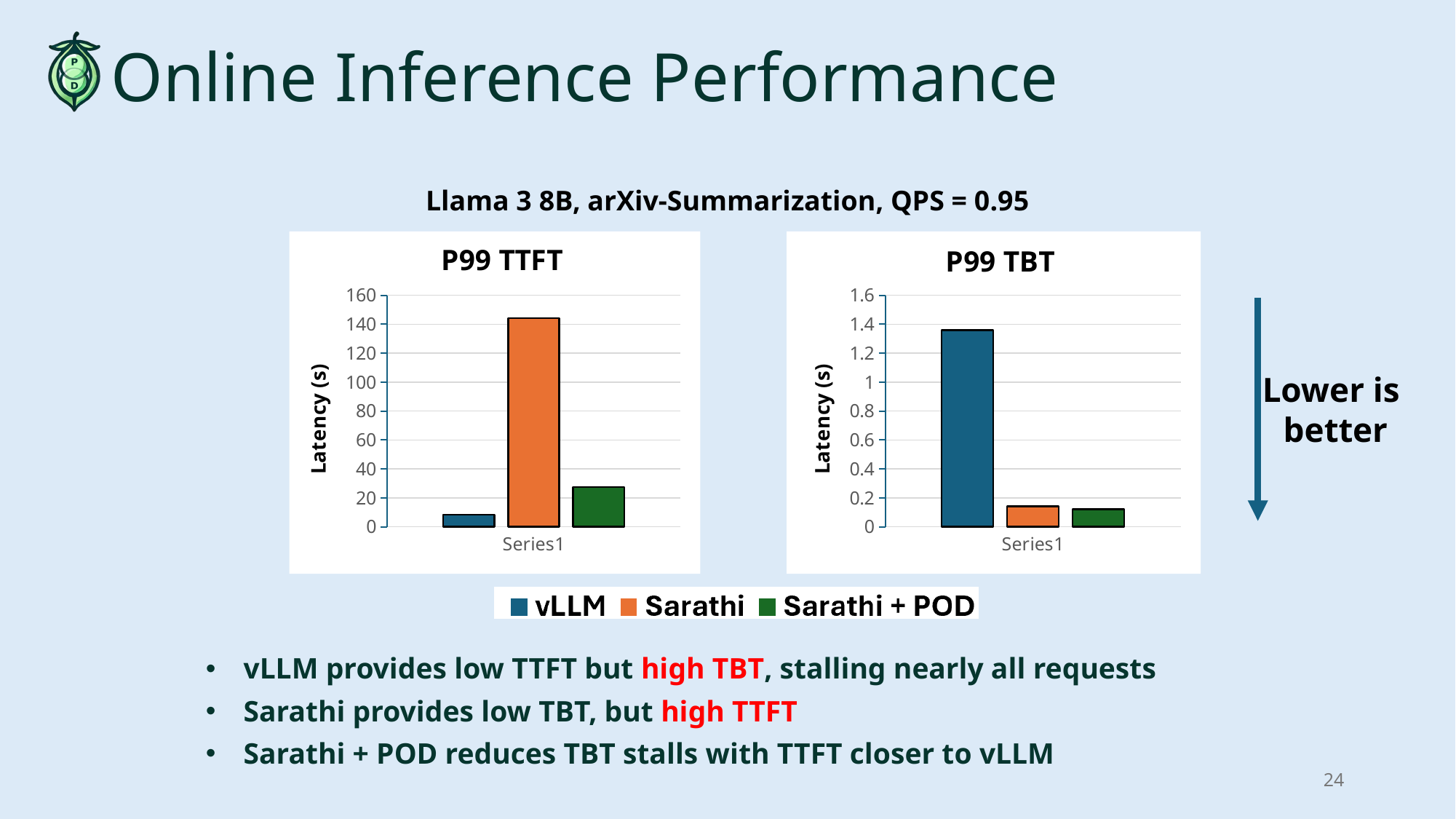
In the P99 TTFT chart, is the value for Sarathi greater or less than 140? greater What kind of chart is the P99 TBT chart? Bar chart In the P99 TBT chart, is the value for Sarathi greater or less than 0.4? less In the P99 TTFT chart, is the value for Sarathi + POD greater or less than 40? less In the P99 TTFT chart, which series has the lowest latency? vLLM What is the y-axis label on the P99 TTFT chart? Latency (s) How many series does the shared legend list? 3 In the P99 TBT chart, which is larger, the value for vLLM or the value for Sarathi? vLLM In the P99 TTFT chart, which series has the highest latency? Sarathi In the P99 TBT chart, which series has the highest latency? vLLM In the P99 TTFT chart, which is larger, the value for vLLM or the value for Sarathi + POD? Sarathi + POD